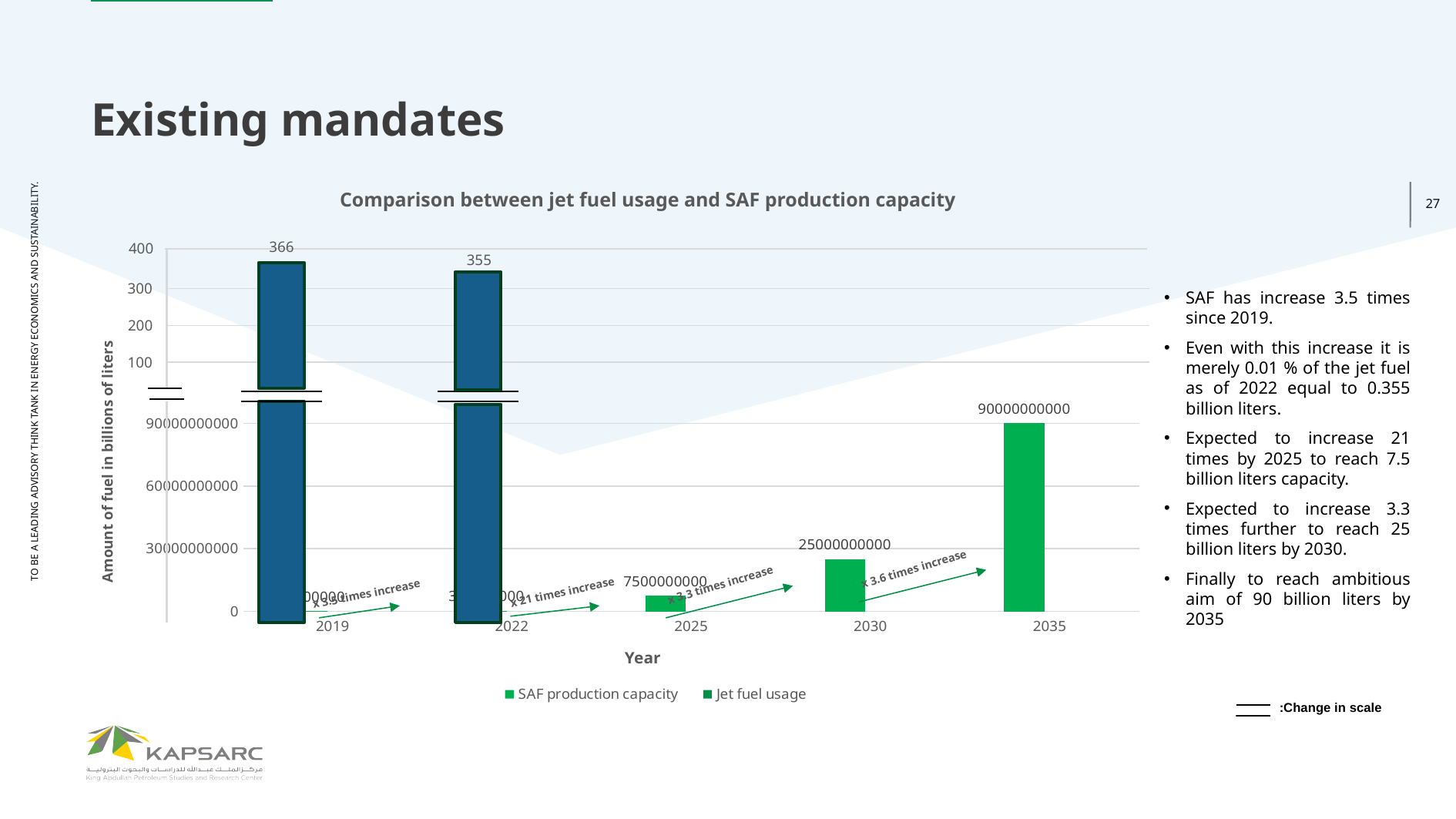
How many years are shown on the x axis? 5 How many series does the legend list? 2 What is the title of the x axis? Year What is the SAF production capacity value labelled for 2035? 90000000000 What kind of chart is shown on the slide? Bar chart What is the SAF production capacity value labelled for 2025? 7500000000 What is the difference between the jet fuel usage labels for 2019 and 2022? 11 What is the jet fuel usage value labelled for 2022? 355 What is the jet fuel usage value labelled for 2019? 366 What is the difference between the SAF production capacity labels for 2035 and 2030? 65000000000 In which year is SAF production capacity highest? 2035 What is the SAF production capacity value labelled for 2030? 25000000000